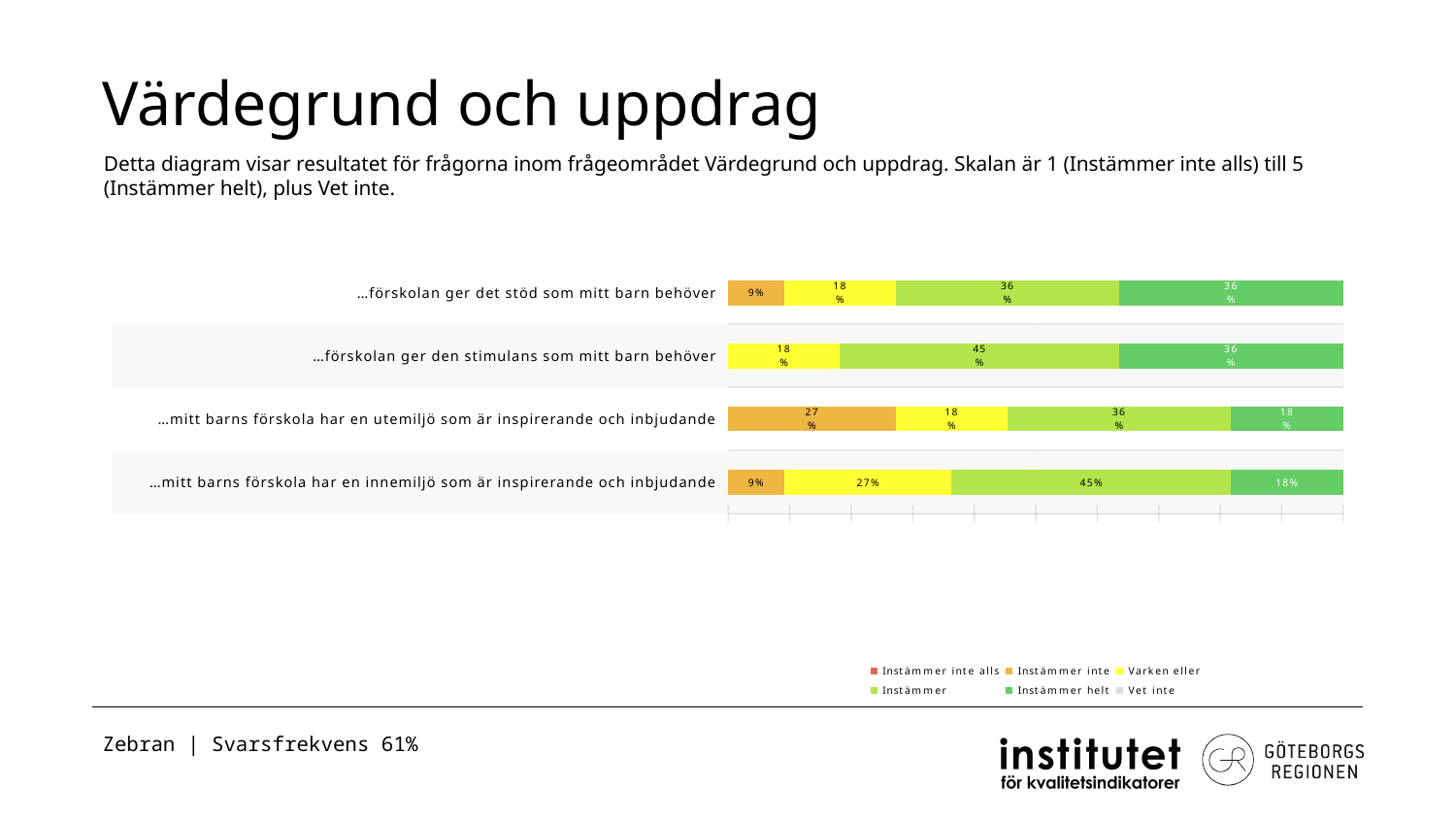
What is the 'Varken eller' value for '…mitt barns förskola har en innemiljö som är inspirerande och inbjudande'? 27% How many categories (questions) are plotted in the chart? 4 What is the difference between the 'Instämmer' value and the 'Instämmer helt' value for '…mitt barns förskola har en innemiljö som är inspirerande och inbjudande'? 27% What is the 'Instämmer' value for '…förskolan ger den stimulans som mitt barn behöver'? 45% Which legend entry is shown in yellow? Varken eller Which is larger: the 'Instämmer helt' value for '…förskolan ger den stimulans som mitt barn behöver' or for '…mitt barns förskola har en utemiljö som är inspirerande och inbjudande'? …förskolan ger den stimulans som mitt barn behöver What is the 'Instämmer inte' value for '…mitt barns förskola har en utemiljö som är inspirerande och inbjudande'? 27% What kind of chart is shown on the slide? Stacked bar chart How many series does the legend list? 6 Which category has the highest 'Instämmer inte' value? …mitt barns förskola har en utemiljö som är inspirerande och inbjudande What is the combined share of 'Instämmer' and 'Instämmer helt' for '…förskolan ger det stöd som mitt barn behöver'? 72% What is the 'Instämmer helt' value for '…förskolan ger det stöd som mitt barn behöver'? 36%